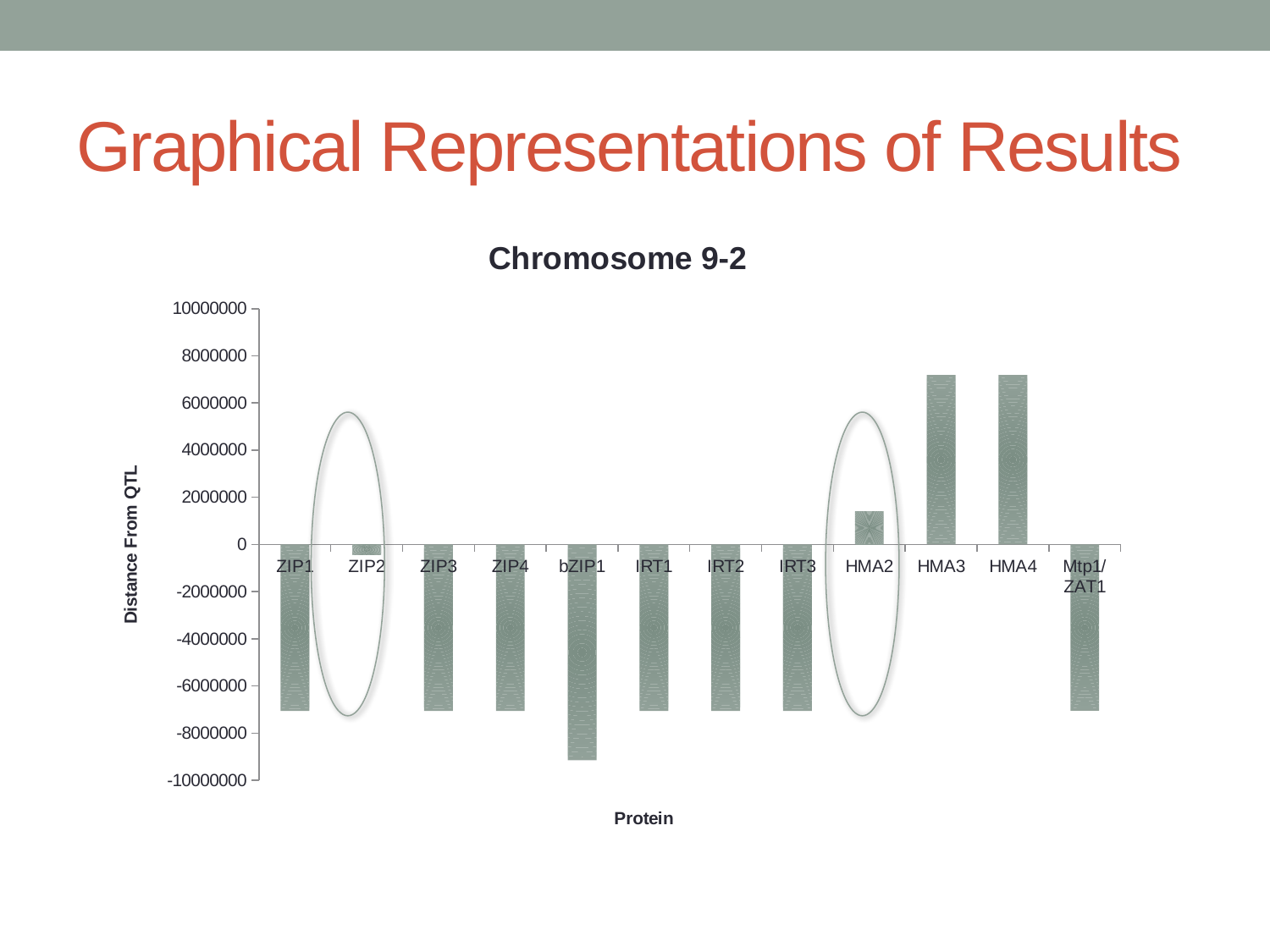
How many proteins have a positive distance from QTL? 3 Which has the larger value, HMA2 or HMA3? HMA3 Is the value for bZIP1 greater or less than -8000000? less What is the label of the y axis? Distance From QTL What type of chart is shown on the slide? Bar chart What is the title of the chart? Chromosome 9-2 Is the value for HMA2 greater or less than 2000000? less Is the value for HMA3 greater or less than 6000000? greater Which protein has the lowest (most negative) distance from QTL? bZIP1 Which has the larger value, ZIP2 or bZIP1? ZIP2 How many proteins are plotted on the x axis of the chart? 12